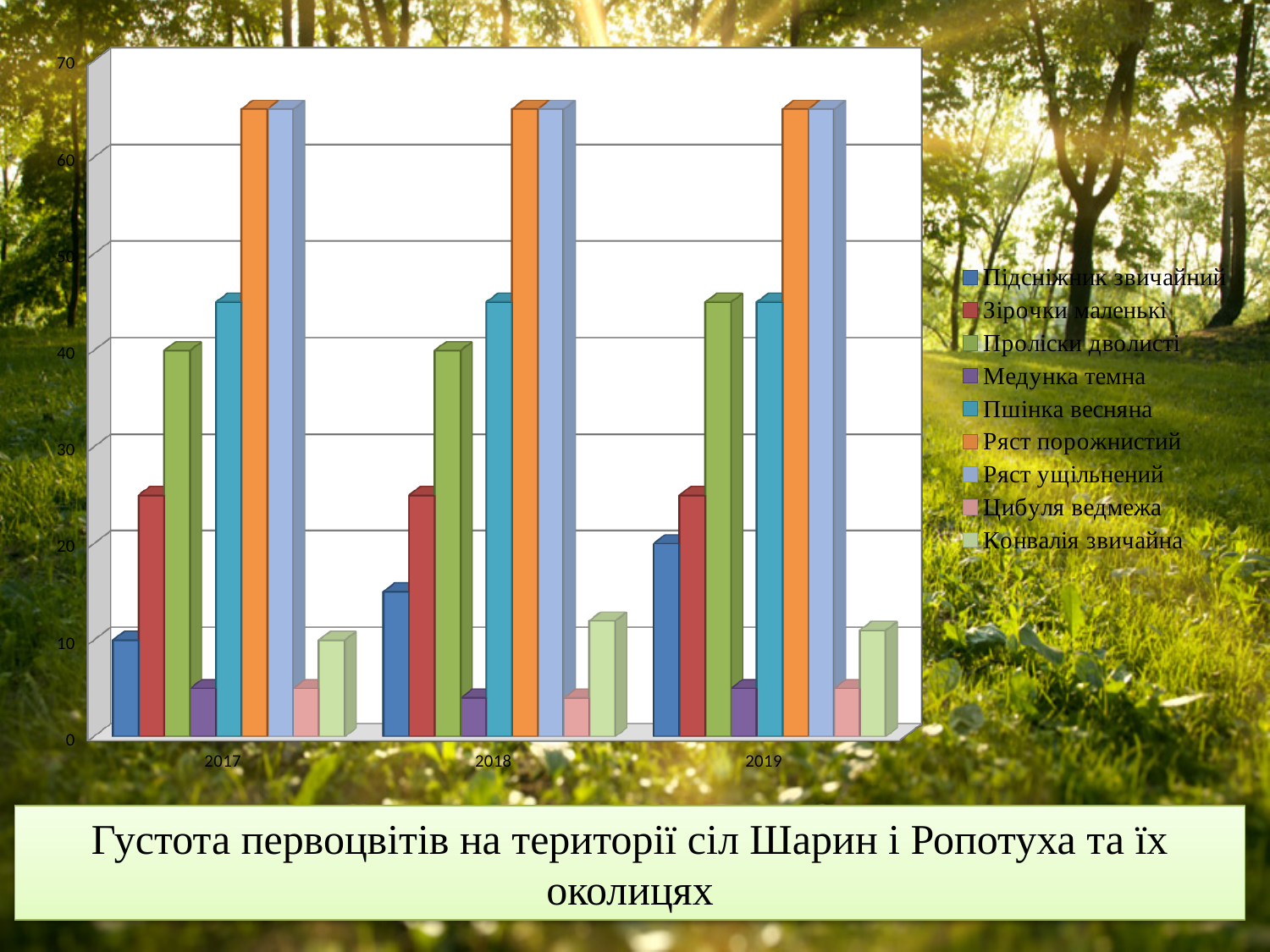
Is the value for Ряст порожнистий in 2017 greater or less than 60? greater What is the title shown below the chart? Густота первоцвітів на території сіл Шарин і Ропотуха та їх околицях What kind of chart is shown on the slide? bar chart In 2018, which is larger: Пшінка весняна or Підсніжник звичайний? Пшінка весняна Is the value for Підсніжник звичайний in 2019 greater or less than 30? less Is the value for Пшінка весняна in 2019 greater or less than 40? greater How many years are shown along the x axis? 3 How many series does the legend list? 9 In 2017, which is larger: Проліски дволисті or Зірочки маленькі? Проліски дволисті Does the value for Підсніжник звичайний rise or fall from 2017 to 2019? rise